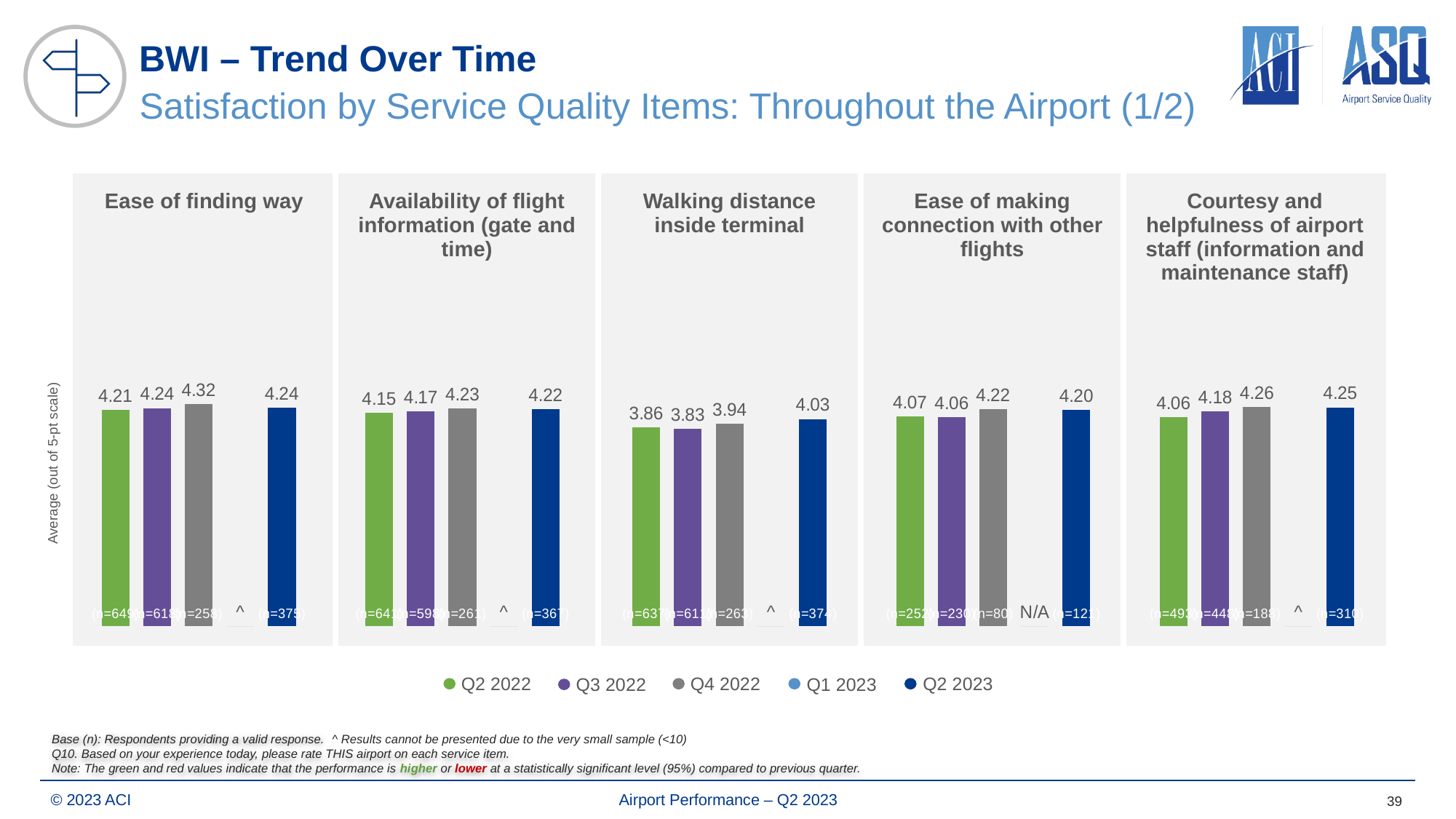
In the 'Ease of making connection with other flights' chart, which is larger: the Q4 2022 value or the Q2 2023 value? Q4 2022 In the 'Ease of making connection with other flights' chart, what is the value for Q2 2022? 4.07 In the 'Walking distance inside terminal' chart, which quarter has the lowest value? Q3 2022 In the 'Walking distance inside terminal' chart, is the value for Q2 2023 greater or less than 4? greater What kind of chart is used to show the satisfaction scores on this slide? Bar chart Which legend entry is shown in green? Q2 2022 In the 'Walking distance inside terminal' chart, what is the difference between the Q4 2022 value and the Q3 2022 value? 0.11 In the 'Availability of flight information (gate and time)' chart, what is the difference between the Q2 2023 value and the Q2 2022 value? 0.07 In the 'Courtesy and helpfulness of airport staff' chart, which quarter has the highest value? Q4 2022 In the 'Walking distance inside terminal' chart, what is the value for Q2 2023? 4.03 In the 'Ease of finding way' chart, what is the value for Q4 2022? 4.32 How many series does the legend list? 5